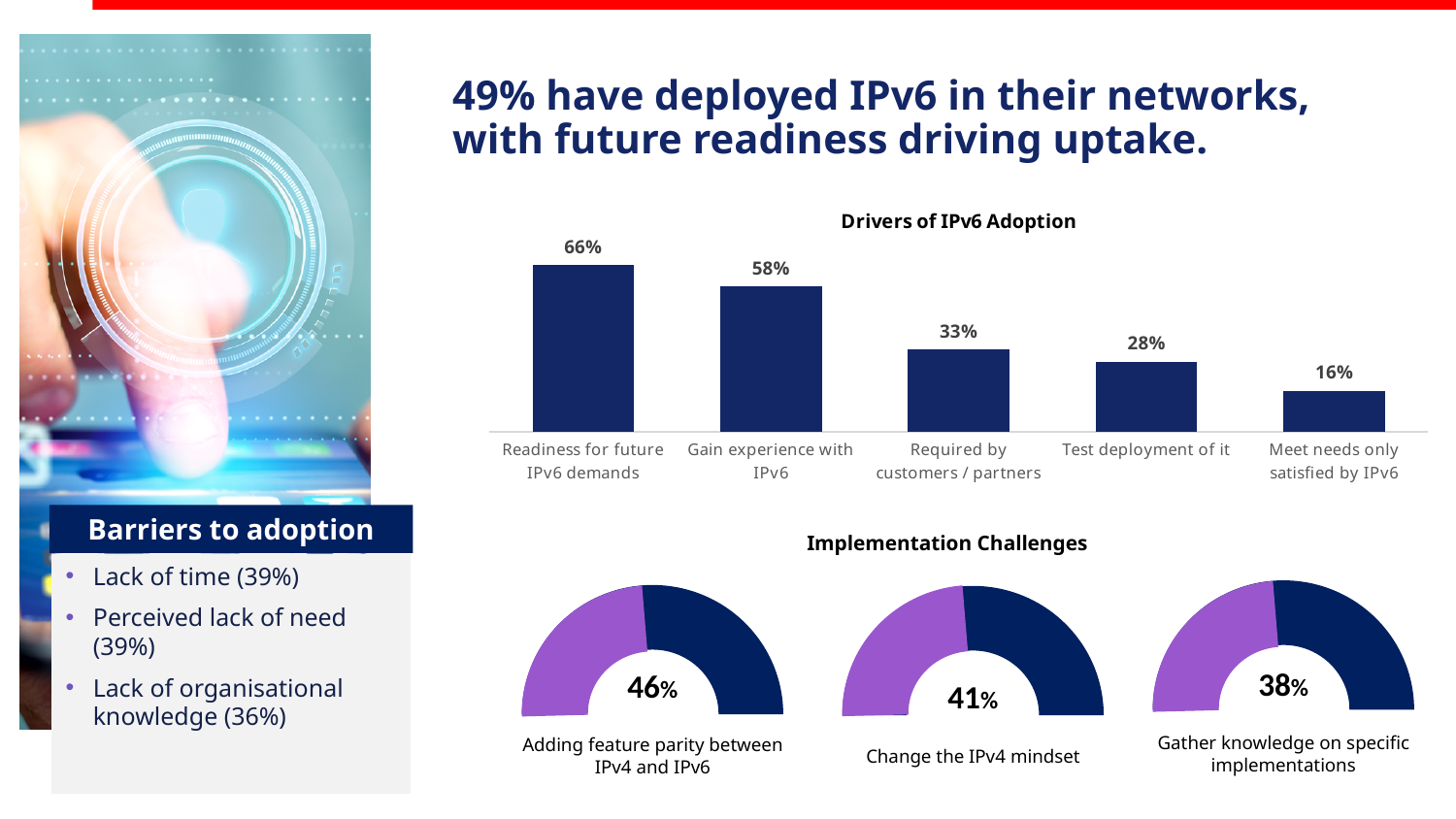
In the 'Implementation Challenges' section, what is the difference between 'Adding feature parity between IPv4 and IPv6' and 'Gather knowledge on specific implementations'? 8% How many categories are shown in the 'Drivers of IPv6 Adoption' chart? 5 In the 'Implementation Challenges' section, what is the value for 'Change the IPv4 mindset'? 41% In the 'Drivers of IPv6 Adoption' chart, which is larger: 'Required by customers / partners' or 'Test deployment of it'? Required by customers / partners In the 'Drivers of IPv6 Adoption' chart, do the values rise or fall from left to right? Fall In the 'Drivers of IPv6 Adoption' chart, what is the value for 'Readiness for future IPv6 demands'? 66% What kind of chart is 'Drivers of IPv6 Adoption'? Bar chart In the 'Drivers of IPv6 Adoption' chart, what is the value for 'Test deployment of it'? 28% In the 'Drivers of IPv6 Adoption' chart, what is the difference between 'Gain experience with IPv6' and 'Required by customers / partners'? 25% In the 'Implementation Challenges' section, which challenge has the highest value? Adding feature parity between IPv4 and IPv6 In the 'Drivers of IPv6 Adoption' chart, which category has the highest value? Readiness for future IPv6 demands In the 'Drivers of IPv6 Adoption' chart, which category has the lowest value? Meet needs only satisfied by IPv6